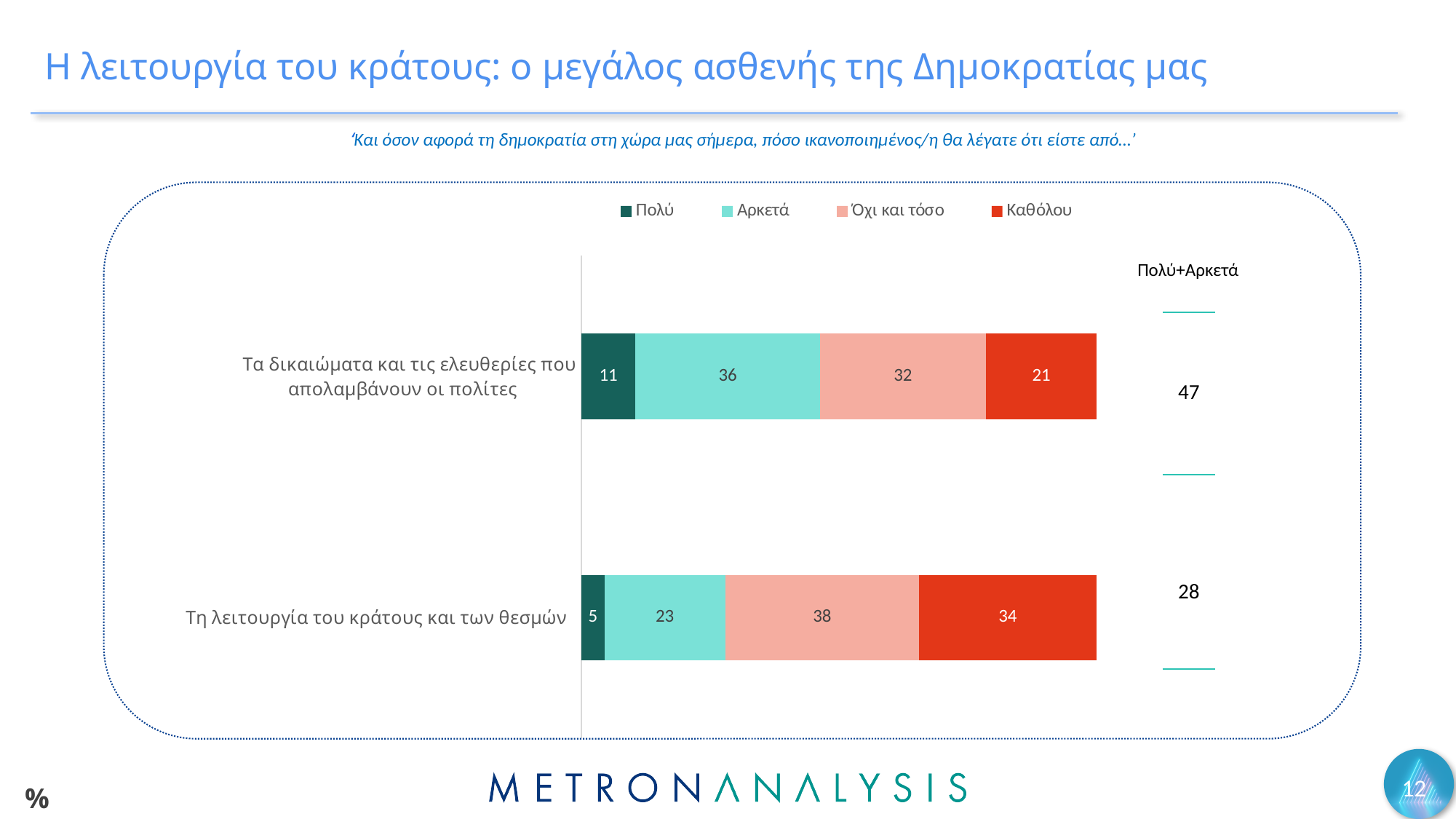
What is the value for 'Καθόλου' for 'Τη λειτουργία του κράτους και των θεσμών'? 34 What kind of chart is shown on the slide? Stacked bar chart What is the difference between the 'Όχι και τόσο' values of the two categories? 6 Which category has the lower 'Πολύ' value? Τη λειτουργία του κράτους και των θεσμών What is the total of the stacked bar for 'Τη λειτουργία του κράτους και των θεσμών'? 100 What is the value for 'Αρκετά' for 'Τα δικαιώματα και τις ελευθερίες που απολαμβάνουν οι πολίτες'? 36 How many series does the legend list? 4 Which category has the higher 'Καθόλου' value? Τη λειτουργία του κράτους και των θεσμών What is the 'Πολύ+Αρκετά' value shown for 'Τα δικαιώματα και τις ελευθερίες που απολαμβάνουν οι πολίτες'? 47 Is the 'Αρκετά' value larger for 'Τα δικαιώματα και τις ελευθερίες που απολαμβάνουν οι πολίτες' or for 'Τη λειτουργία του κράτους και των θεσμών'? Τα δικαιώματα και τις ελευθερίες που απολαμβάνουν οι πολίτες How many categories are shown in the chart? 2 What is the value for 'Πολύ' for 'Τη λειτουργία του κράτους και των θεσμών'? 5